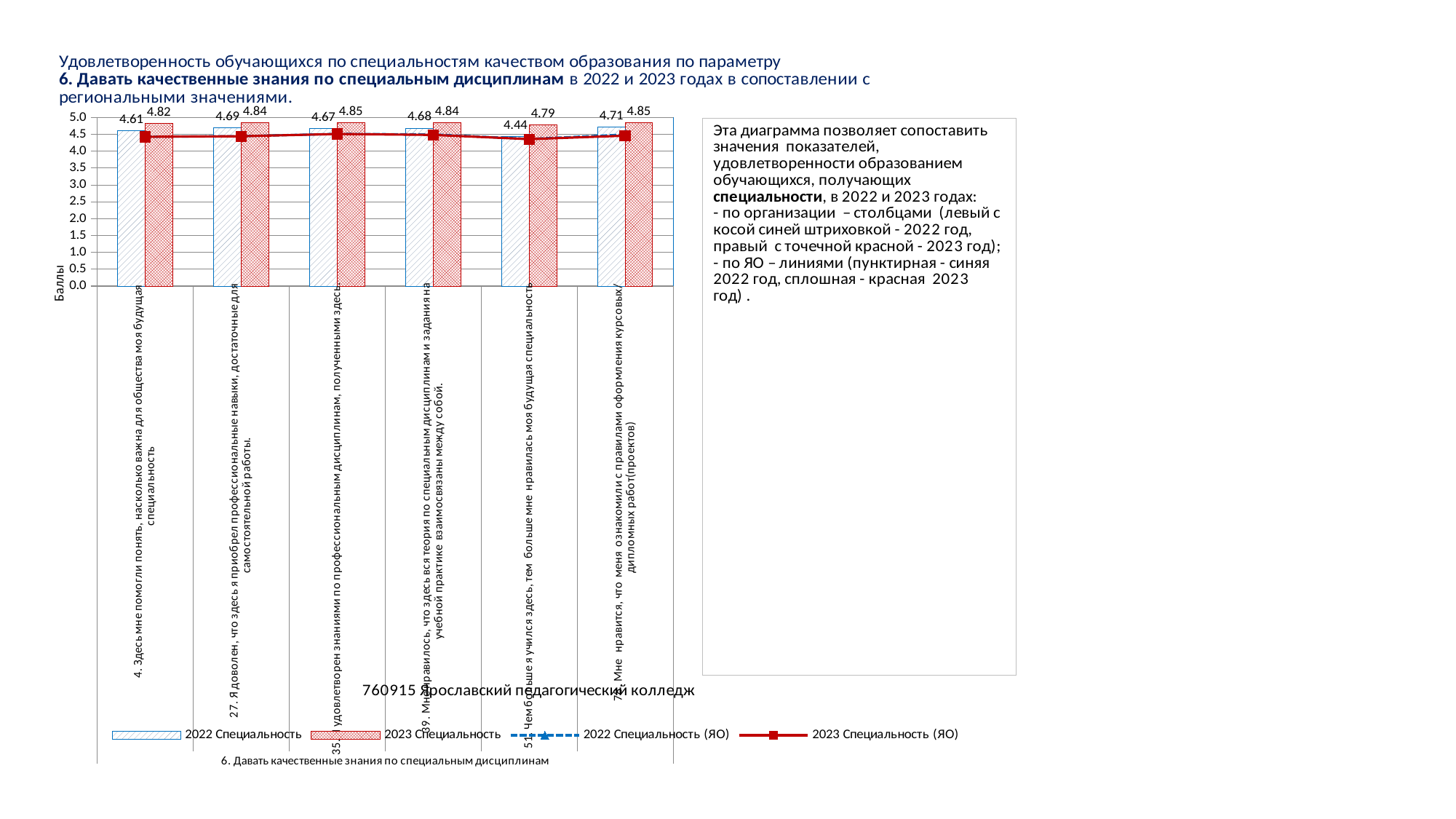
What is the difference between the 2023 and 2022 Специальность values for item 4? 0.21 What is the difference between the 2023 and 2022 Специальность values for item 51? 0.35 Which item has the lowest 2022 Специальность value? 51. Чем больше я учился здесь, тем больше мне нравилась моя будущая специальность Which item has the lowest 2023 Специальность value? 51. Чем больше я учился здесь, тем больше мне нравилась моя будущая специальность Is the 2023 Специальность (ЯО) line value for item 51 greater or less than 4.5? less What is the 2023 Специальность value for item 27 (Я доволен, что здесь я приобрел профессиональные навыки)? 4.84 For item 39, which is larger: the 2022 Специальность value or the 2023 Специальность value? 2023 Специальность How many items (categories) are shown on the x axis of the chart? 6 What is the 2022 Специальность value for item 4 (Здесь мне помогли понять, насколько важна для общества моя будущая специальность)? 4.61 How many series does the chart legend list? 4 What is the label of the vertical axis of the chart? Баллы What is the 2022 Специальность value for item 51 (Чем больше я учился здесь, тем больше мне нравилась моя будущая специальность)? 4.44